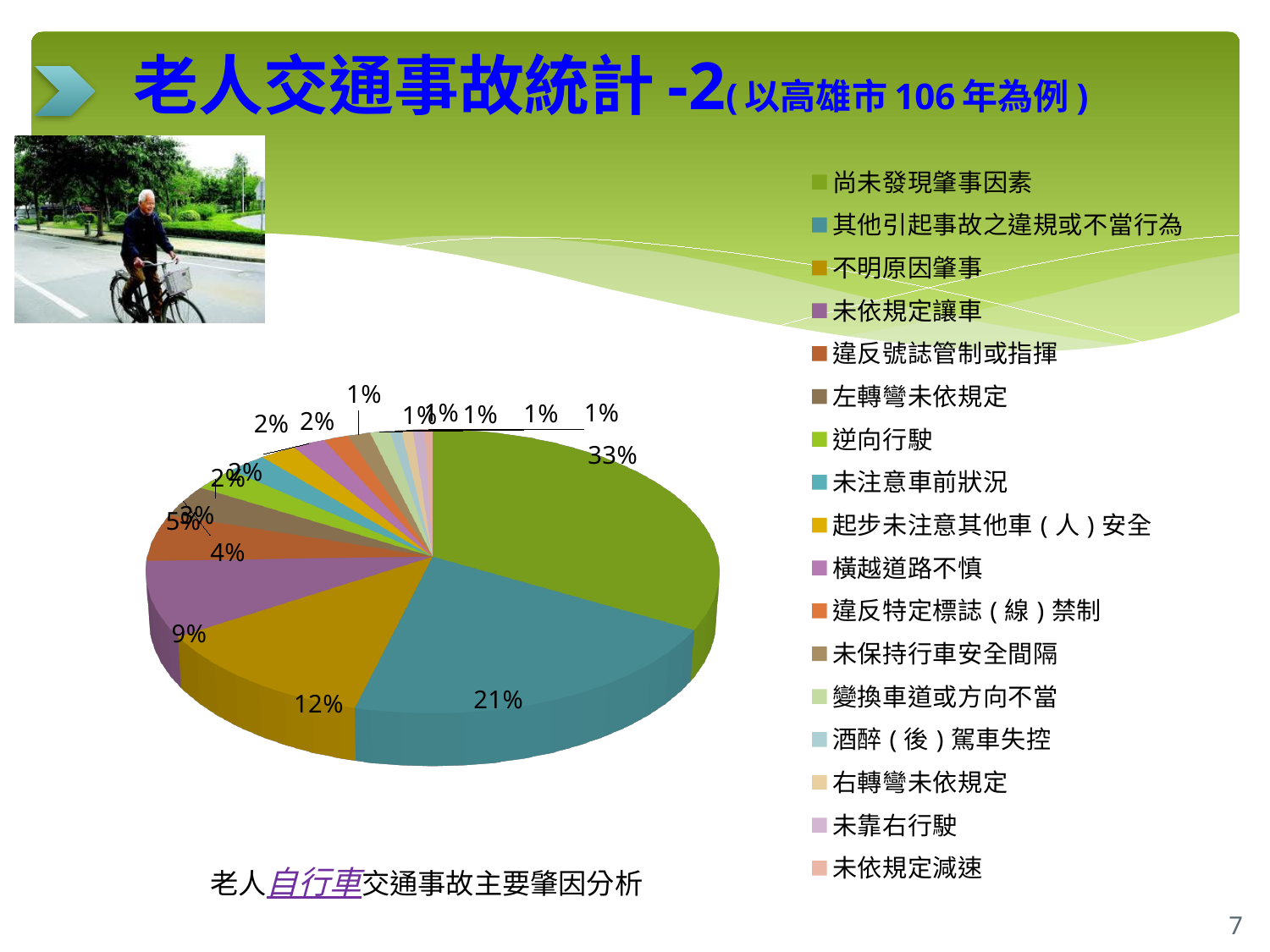
What is the difference in percentage points between 尚未發現肇事因素 and 其他引起事故之違規或不當行為? 12 percentage points What percentage is shown for 不明原因肇事? 12% What kind of chart is shown on the slide? Pie chart What percentage is shown for 尚未發現肇事因素? 33% What percentage is shown for 未依規定讓車? 9% What is the combined share of the two largest slices, 尚未發現肇事因素 and 其他引起事故之違規或不當行為? 54% Which category has the largest slice in the pie chart? 尚未發現肇事因素 Which is larger, the slice for 不明原因肇事 or the slice for 未依規定讓車? 不明原因肇事 How many categories does the legend of the pie chart list? 17 Which city and year does the slide title say the statistics are taken from? 高雄市 106 年 What caption appears below the pie chart? 老人自行車交通事故主要肇因分析 What percentage is shown for 其他引起事故之違規或不當行為? 21%